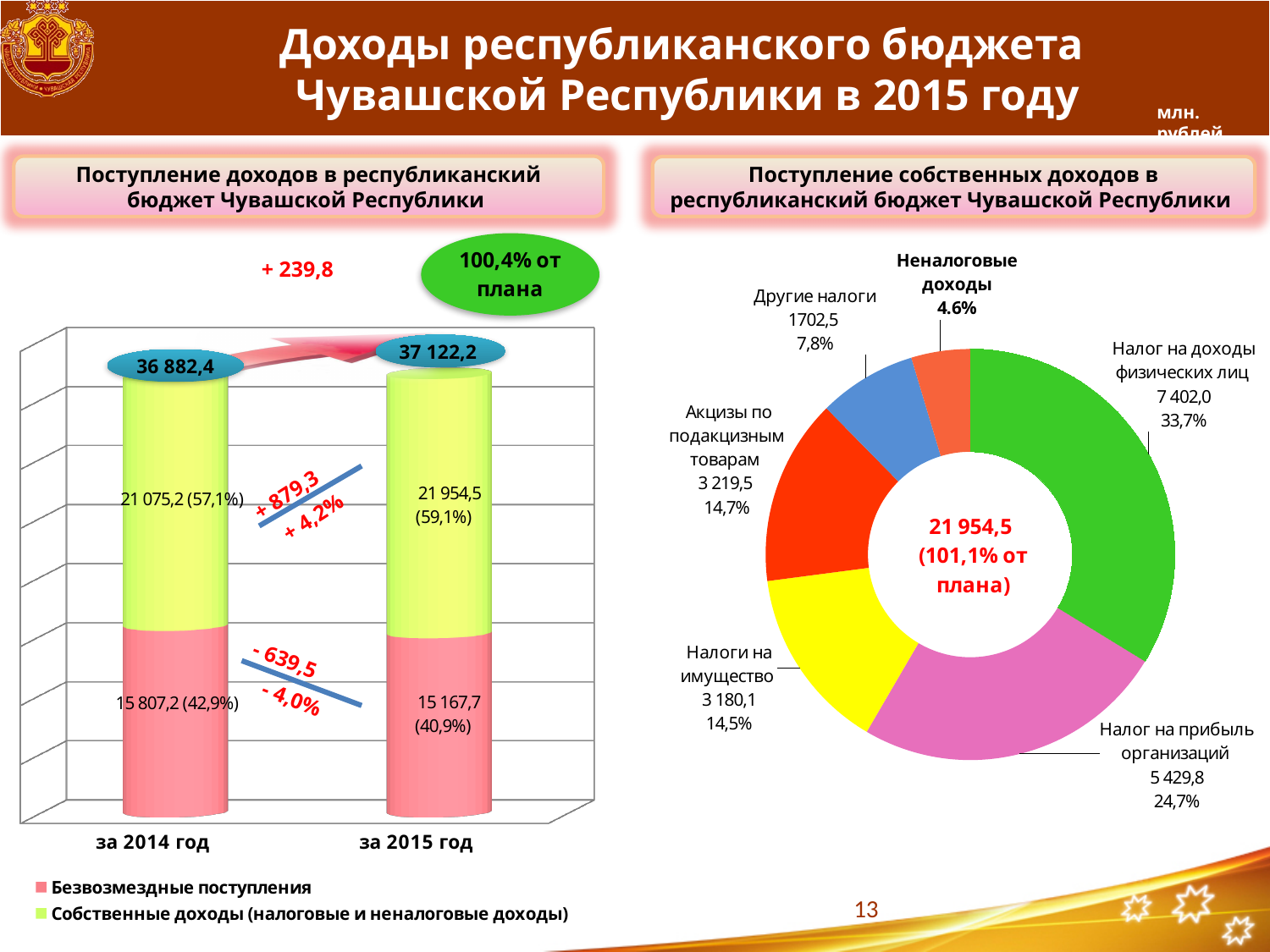
On the left chart, what is the total of the stacked bar for за 2015 год? 37 122,2 On the right chart, how many categories are shown? 6 On the left chart, what is the value of Безвозмездные поступления for за 2014 год? 15 807,2 On the right chart (Поступление собственных доходов), what is the value for Налог на прибыль организаций? 5 429,8 On the left chart, which year has the larger value of Безвозмездные поступления, 2014 or 2015? за 2014 год On the right chart, what share does Акцизы по подакцизным товарам have? 14,7% On the left chart (Поступление доходов в республиканский бюджет Чувашской Республики), what is the value of Собственные доходы for за 2015 год? 21 954,5 What type of chart is the left chart? Stacked bar chart On the right chart, what is the difference between Налог на доходы физических лиц and Налог на прибыль организаций? 1 972,2 On the left chart, how many series does the legend list? 2 On the right chart, which category has the largest share? Налог на доходы физических лиц On the left chart, what is the difference between Собственные доходы in 2015 and in 2014? 879,3